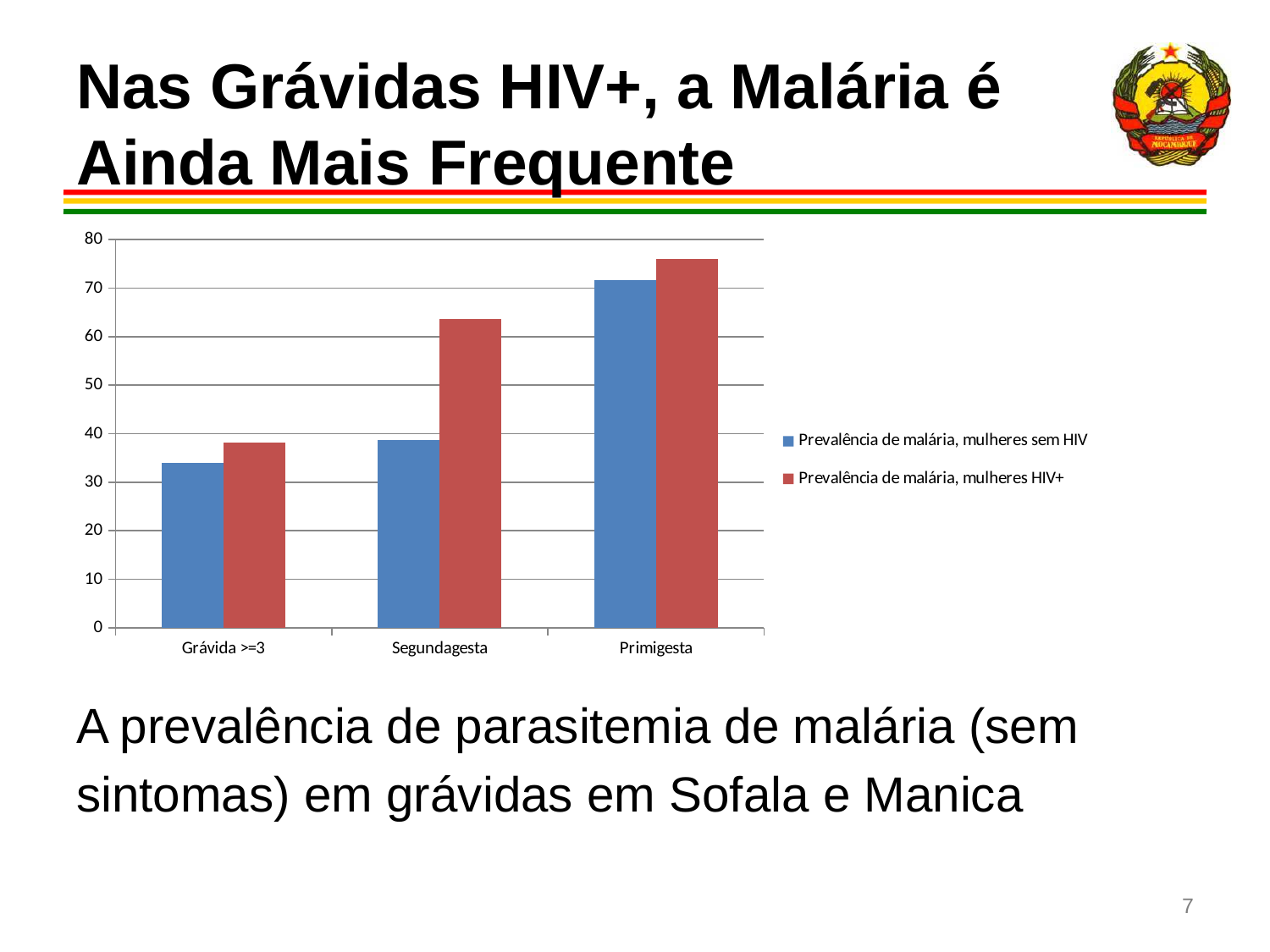
Is the value for 'Prevalência de malária, mulheres sem HIV' in Grávida >=3 greater or less than 40? less What kind of chart is shown on the slide? bar chart Is the value for 'Prevalência de malária, mulheres sem HIV' in Primigesta greater or less than 70? greater How many categories are shown on the x axis of the chart? 3 Do the values for 'Prevalência de malária, mulheres HIV+' rise or fall from Grávida >=3 to Primigesta? rise Which category has the highest value for 'Prevalência de malária, mulheres HIV+'? Primigesta How many series does the chart legend list? 2 For Segundagesta, which series has the larger value: 'mulheres sem HIV' or 'mulheres HIV+'? mulheres HIV+ What is the label of the first category on the x axis? Grávida >=3 Is the value for 'Prevalência de malária, mulheres HIV+' in Segundagesta greater or less than 60? greater Which category has the lowest value for 'Prevalência de malária, mulheres sem HIV'? Grávida >=3 Which colour represents 'Prevalência de malária, mulheres HIV+' in the chart? red